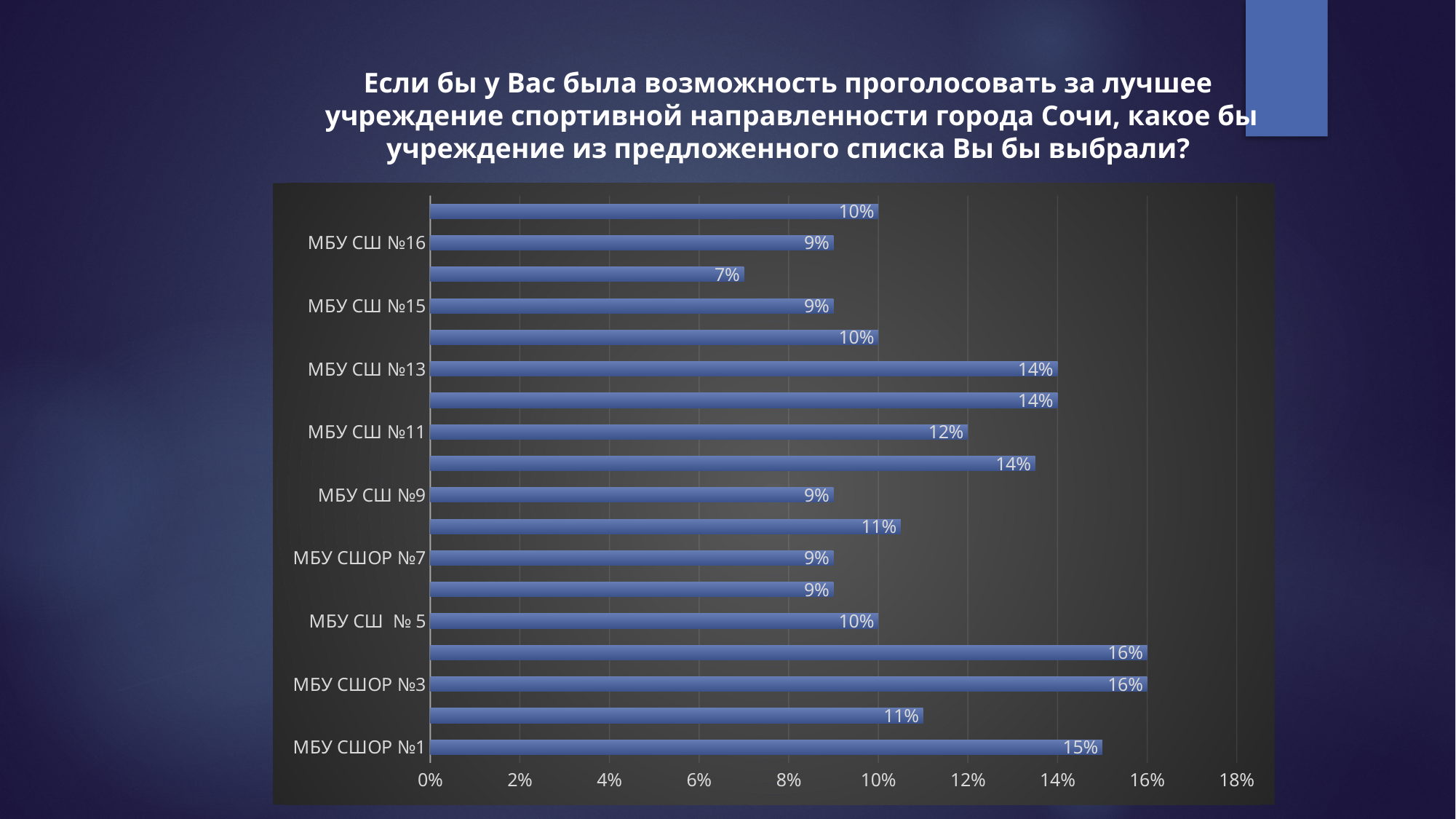
What is the lowest value shown on the chart? 7% What is the value for МБУ СШОР №1? 15% What is the value for МБУ СШ №13? 14% What is the value for МБУ СШ №11? 12% What is the value for МБУ СШ № 5? 10% Which is larger, the value for МБУ СШ №13 or the value for МБУ СШ №11? МБУ СШ №13 What is the highest value shown on the chart? 16% What is the difference between the values for МБУ СШОР №3 and МБУ СШОР №1? 1% What type of chart is shown on the slide? bar chart What is the value for МБУ СШ №16? 9% What is the value for МБУ СШОР №3? 16% How many bars are plotted on the chart? 18